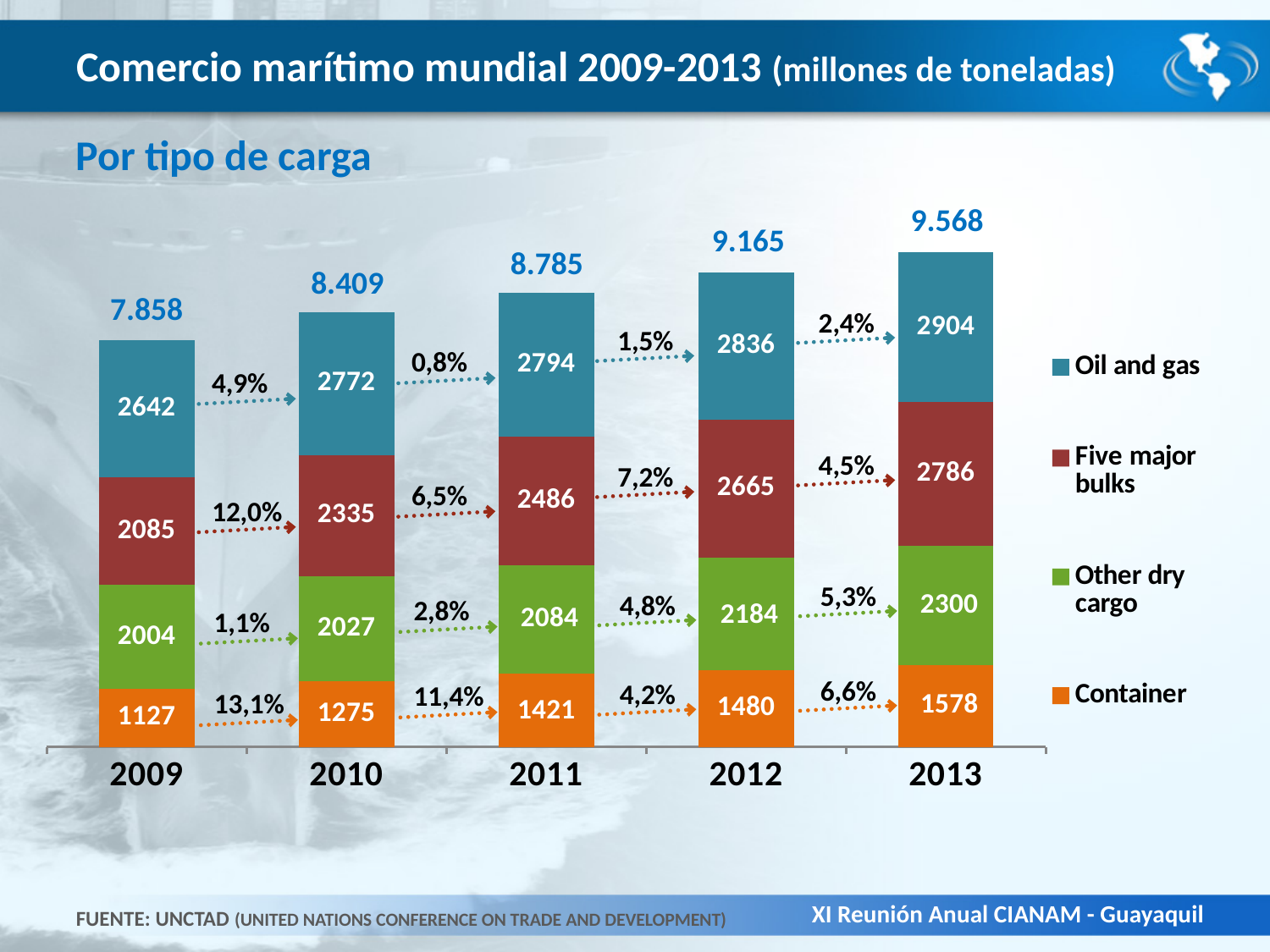
What is the total printed above the stacked bar for 2012? 9.165 Which year has the highest total? 2013 What is the value for Oil and gas in 2013? 2904 What kind of chart is shown on the slide? Stacked bar chart Which is larger, Five major bulks in 2012 or Oil and gas in 2009? Five major bulks in 2012 How many series does the legend list? 4 What is the difference between the Other dry cargo values for 2013 and 2009? 296 How many years are shown on the x axis? 5 What is the value for Five major bulks in 2010? 2335 What is the value for Container in 2011? 1421 Which year has the lowest total? 2009 What growth percentage is shown for Container between 2009 and 2010? 13,1%